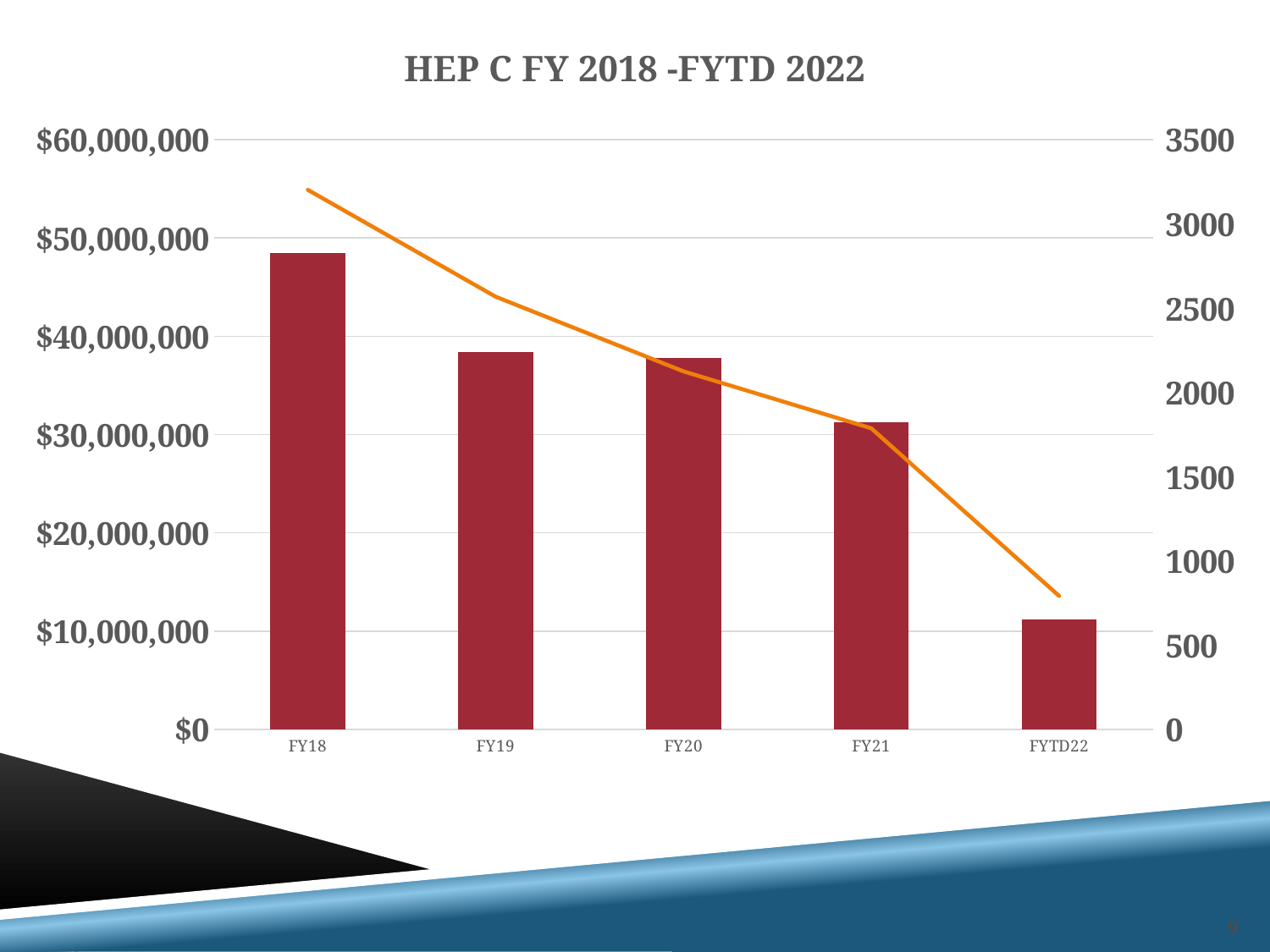
Which has the larger bar value, FY18 or FY21? FY18 Do the bar values rise or fall from FY18 to FYTD22? Fall What kind of chart is shown on the slide? A combination bar and line chart What is the highest value shown on the right-hand axis? 3500 Is the bar value for FYTD22 greater or less than $20,000,000? less Is the orange line value for FY18 greater or less than 3000 on the right axis? greater Which category has the tallest bar? FY18 Is the bar value for FY18 greater or less than $40,000,000? greater What is the title of the chart? HEP C FY 2018 -FYTD 2022 Which category has the shortest bar? FYTD22 How many fiscal-year categories are shown on the x axis? 5 Does the orange line rise or fall from FY18 to FYTD22? Fall